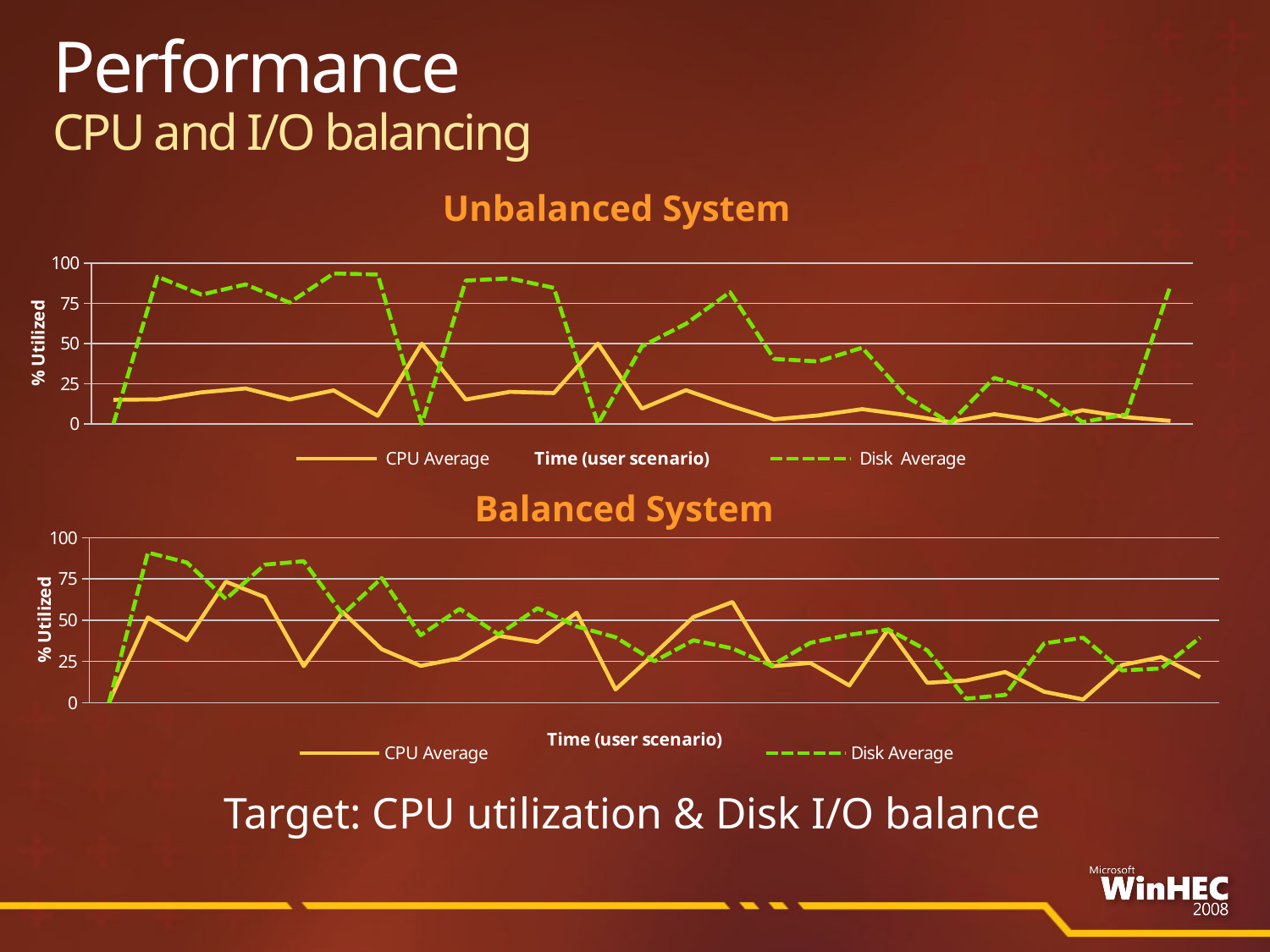
How many series does the legend of the Balanced System chart list? 2 In the Balanced System chart, is the last value of Disk Average greater or less than 25? greater What is the y-axis label of the Balanced System chart? % Utilized In the Balanced System chart, is the highest value of CPU Average greater or less than 50? greater In the Unbalanced System chart, which series reaches the higher peak value, CPU Average or Disk Average? Disk Average What type of chart is the Unbalanced System chart? line chart In the Unbalanced System chart, is the highest value of CPU Average greater or less than 75? less In the Unbalanced System chart, which series is drawn with a dashed green line? Disk Average What is the highest tick value shown on the y-axis of the Unbalanced System chart? 100